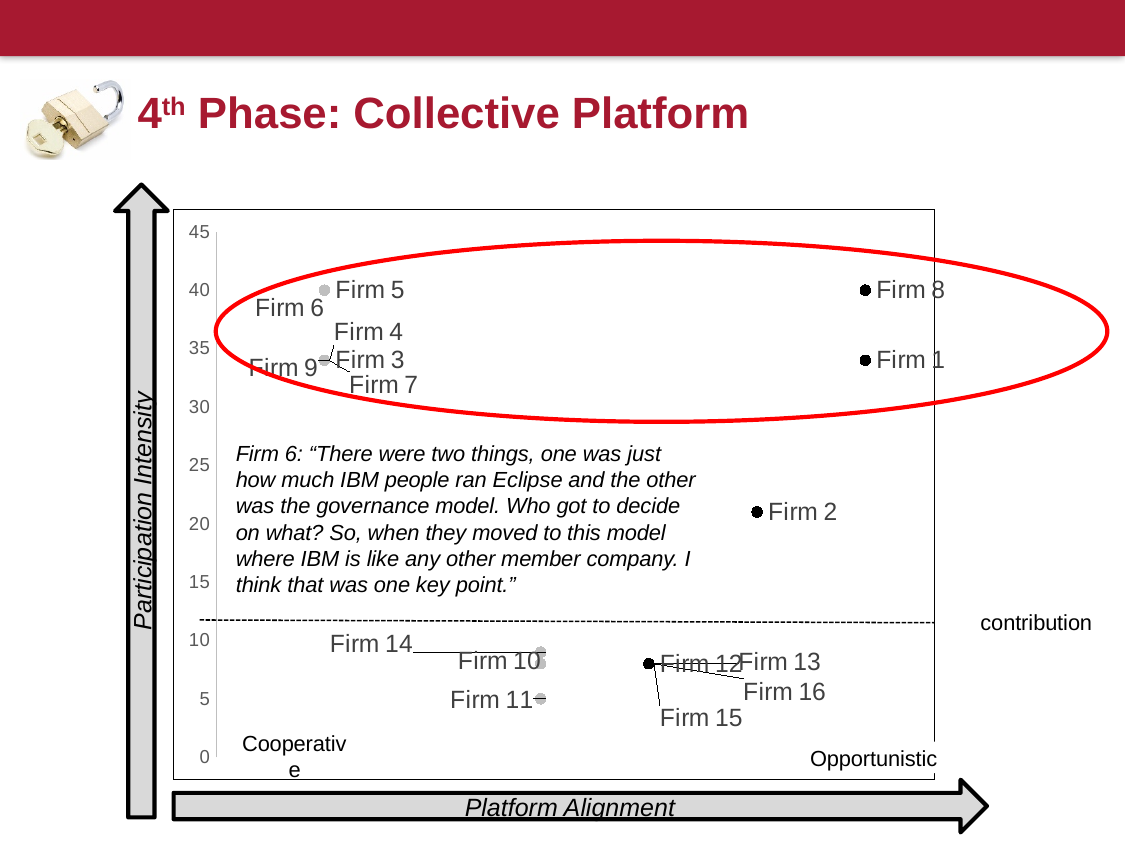
How many firms are plotted on the chart? 16 Is the participation intensity for Firm 2 greater or less than 30? less What is the label of the vertical axis of the chart? Participation Intensity Is the participation intensity for Firm 1 greater or less than 30? greater What is the participation intensity value for Firm 8? 40 Which has a higher participation intensity, Firm 5 or Firm 10? Firm 5 Which firm has the lowest participation intensity? Firm 11 What kind of chart is shown on the slide? Scatter chart What is the label of the horizontal axis of the chart? Platform Alignment Which has a higher participation intensity, Firm 8 or Firm 2? Firm 8 What is the participation intensity value for Firm 11? 5 Is the participation intensity for Firm 15 greater or less than 10? less